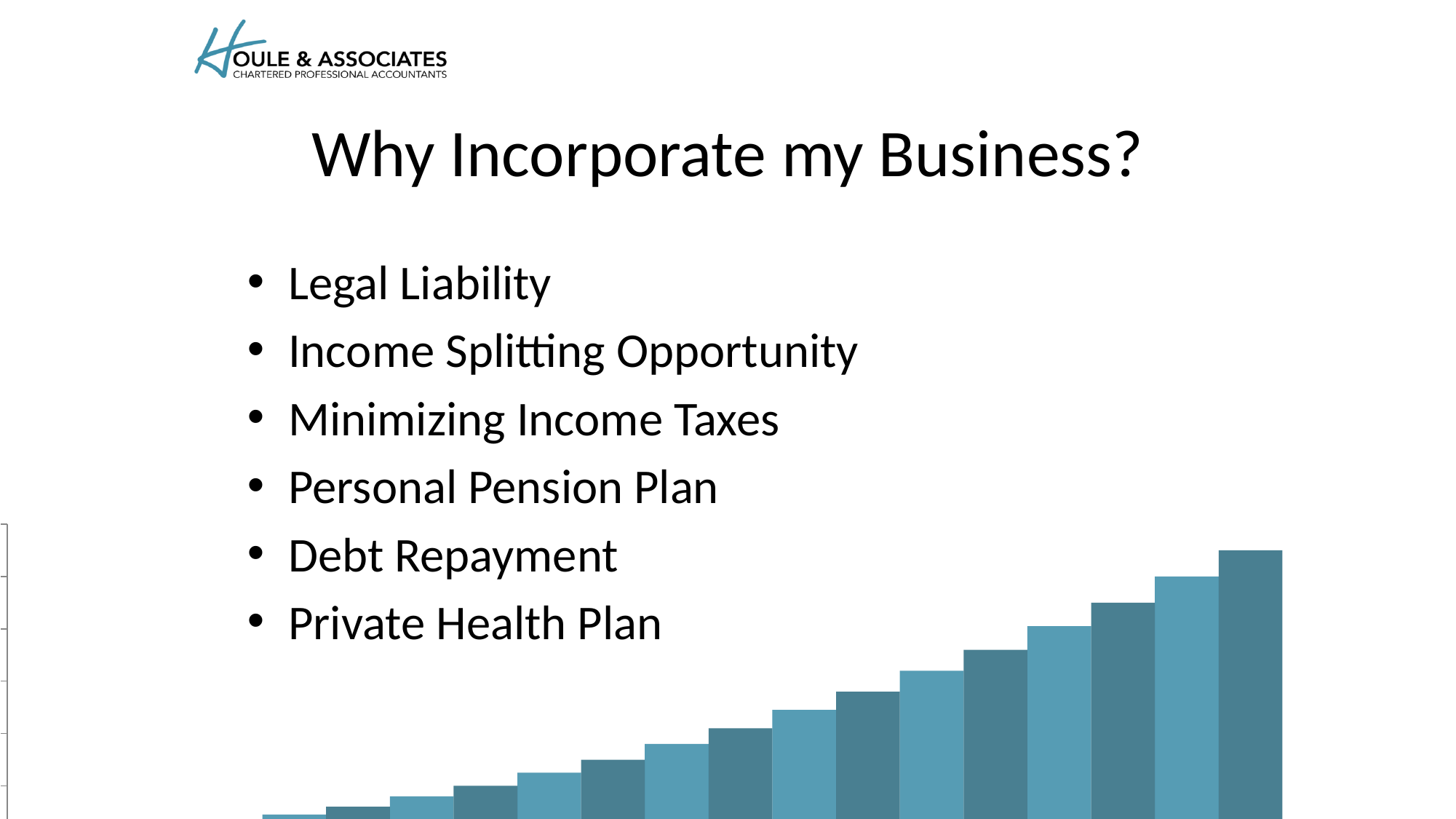
Which bar is the shortest in the chart? the leftmost bar Does the chart display any data labels on its bars? No Is the rightmost bar taller or shorter than the leftmost bar? taller Which bar is the tallest in the chart? the rightmost bar What colour are the bars in the chart? blue-teal Do the bar values rise or fall from left to right along the x axis? rise What kind of chart is shown at the bottom of the slide? bar chart